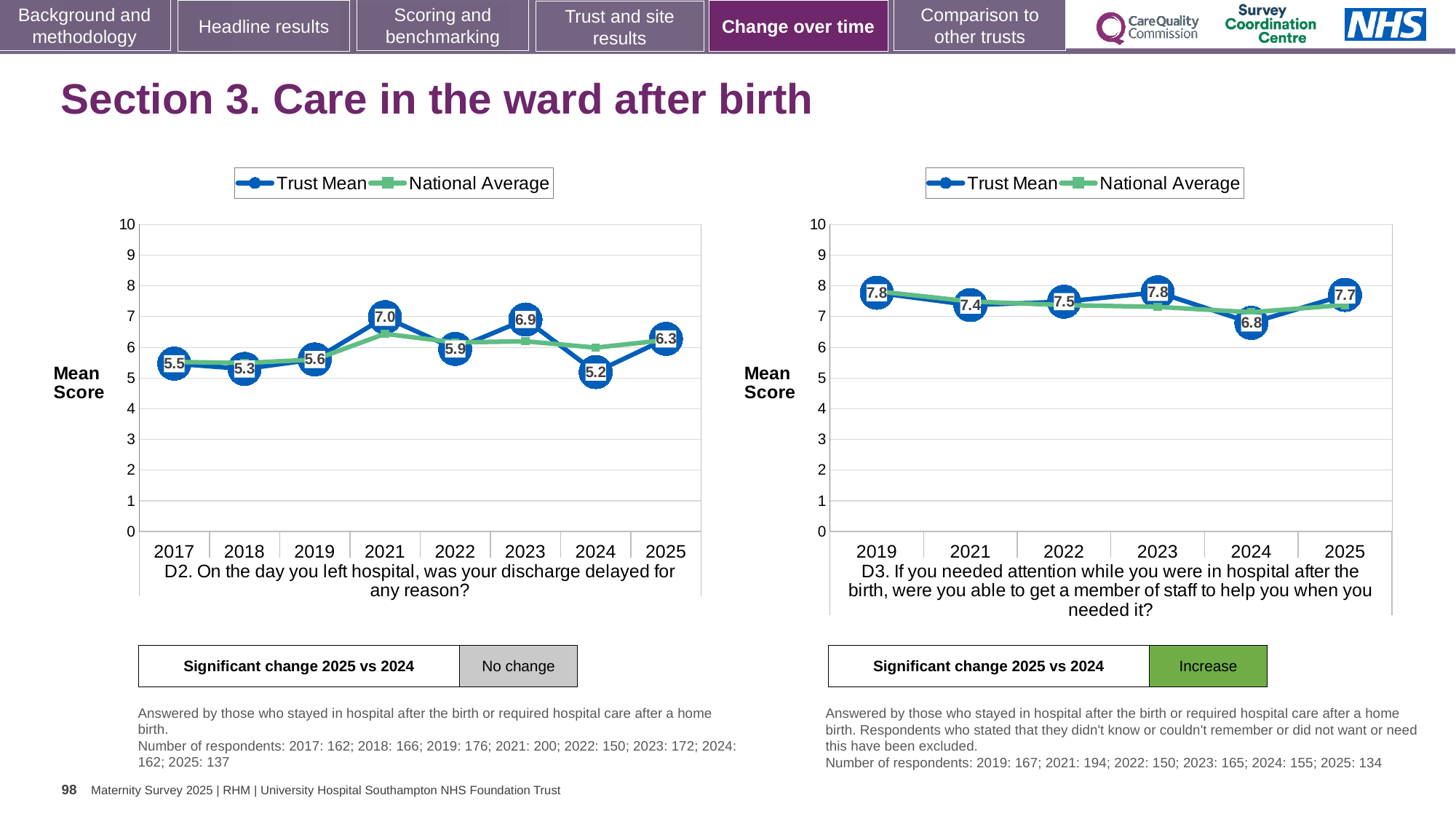
In the D2 chart (left), how many years are plotted on the x axis? 8 In the D3 chart (right), how many series does the legend list? 2 In the D2 chart (left), what is the Trust Mean for 2024? 5.2 In the D2 chart (left), which year has the highest Trust Mean? 2021 In the D3 chart (right), is the National Average for 2024 greater or less than 8? less In the D3 chart (right), which year has the lowest Trust Mean? 2024 In the D3 chart (right), is the Trust Mean for 2022 or 2024 larger? 2022 In the D2 chart (left), which year has the lowest Trust Mean? 2024 In the D3 chart (right), what is the Trust Mean for 2025? 7.7 In the D2 chart (left), what is the Trust Mean for 2021? 7.0 What type of chart is the D3 chart (right)? Line chart In the D2 chart (left), what is the difference between the Trust Mean for 2025 and 2024? 1.1